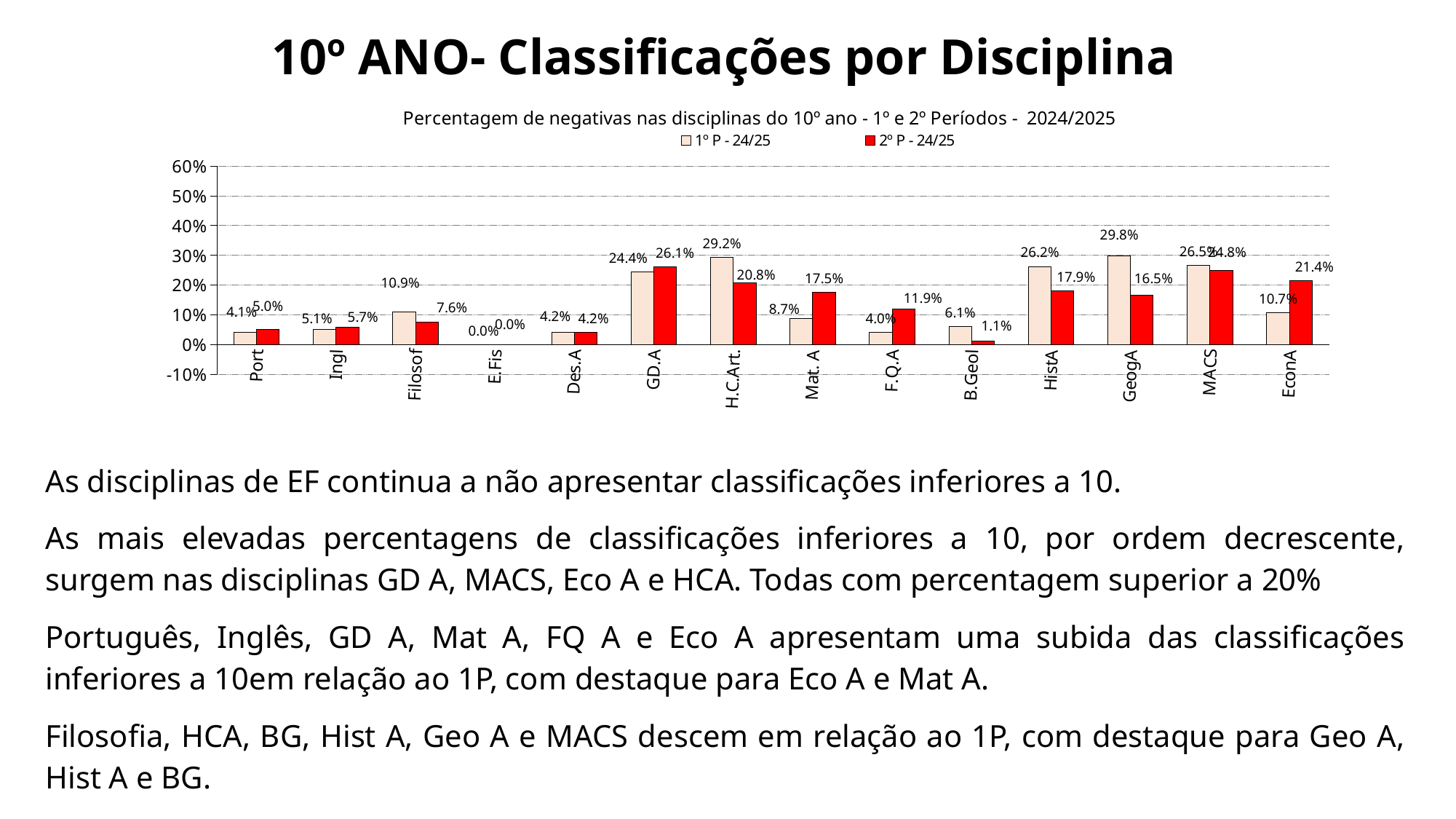
What is the value for Mat. A in the 2º P - 24/25 series? 17.5% Which discipline has the highest value in the 2º P - 24/25 series? GD.A Which discipline has the highest value in the 1º P - 24/25 series? GeogA What is the value for H.C.Art. in the 1º P - 24/25 series? 29.2% Which discipline has the lowest value in the 2º P - 24/25 series? E.Fis What is the difference between the 1º P - 24/25 and 2º P - 24/25 values for GeogA? 13.3 percentage points What is the value for EconA in the 2º P - 24/25 series? 21.4% What is the difference between the 2º P - 24/25 and 1º P - 24/25 values for Mat. A? 8.8 percentage points How many series does the legend list? 2 What kind of chart is shown on the slide? Bar chart Which is larger for B.Geol: the 1º P - 24/25 value or the 2º P - 24/25 value? 1º P - 24/25 How many disciplines are shown on the x axis? 14